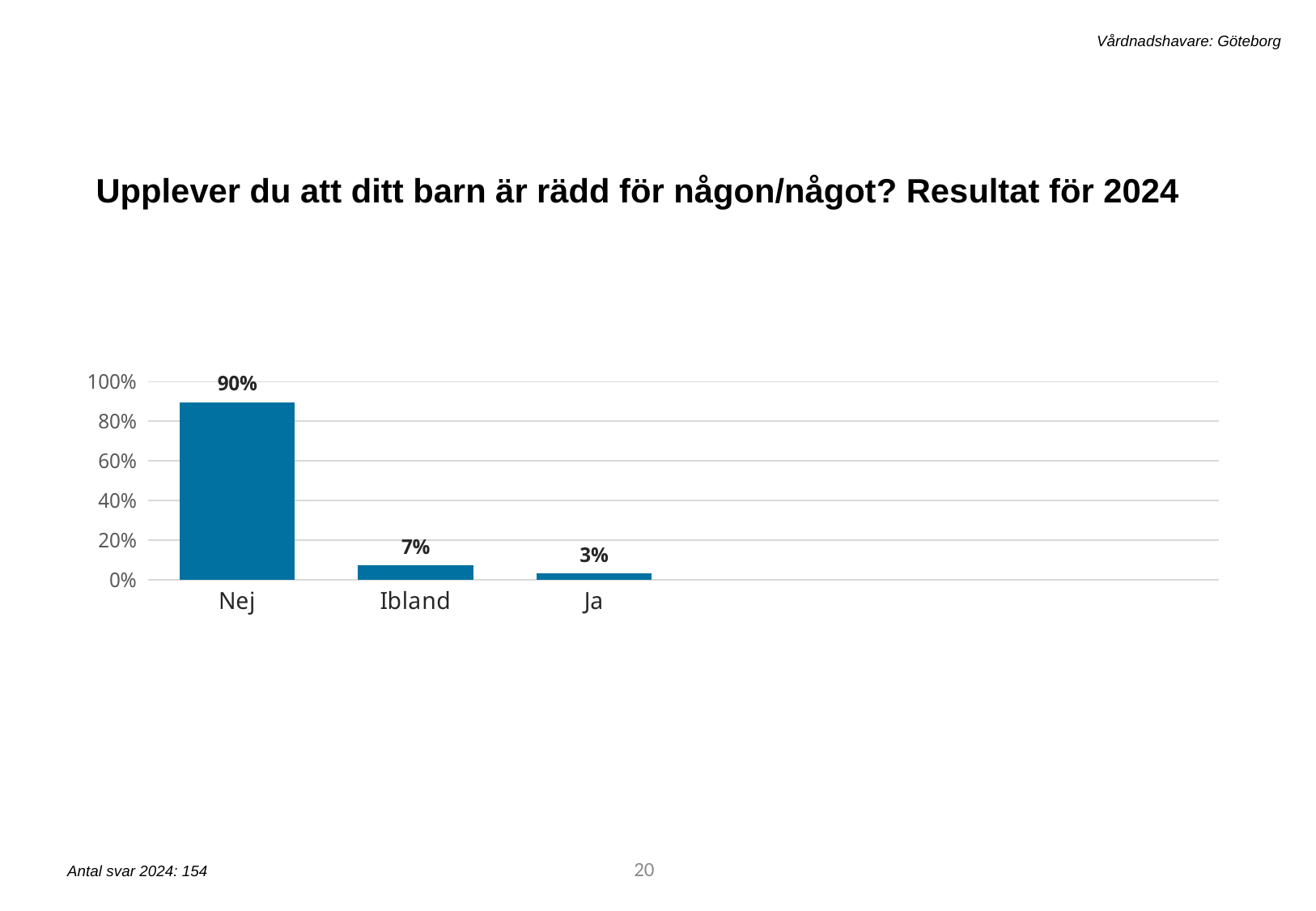
How many categories are shown on the x axis? 3 Do the values rise or fall from left to right along the x axis? Fall What is the value for Ja? 3% What is the value for Ibland? 7% Is the value for Nej greater or less than 80%? greater Which is larger, the value for Ibland or the value for Ja? Ibland What is the difference between the values for Nej and Ibland? 83% What kind of chart is shown on the slide? Bar chart What is the value for Nej? 90% What is the difference between the values for Ibland and Ja? 4% Which category has the highest value? Nej Which category has the lowest value? Ja